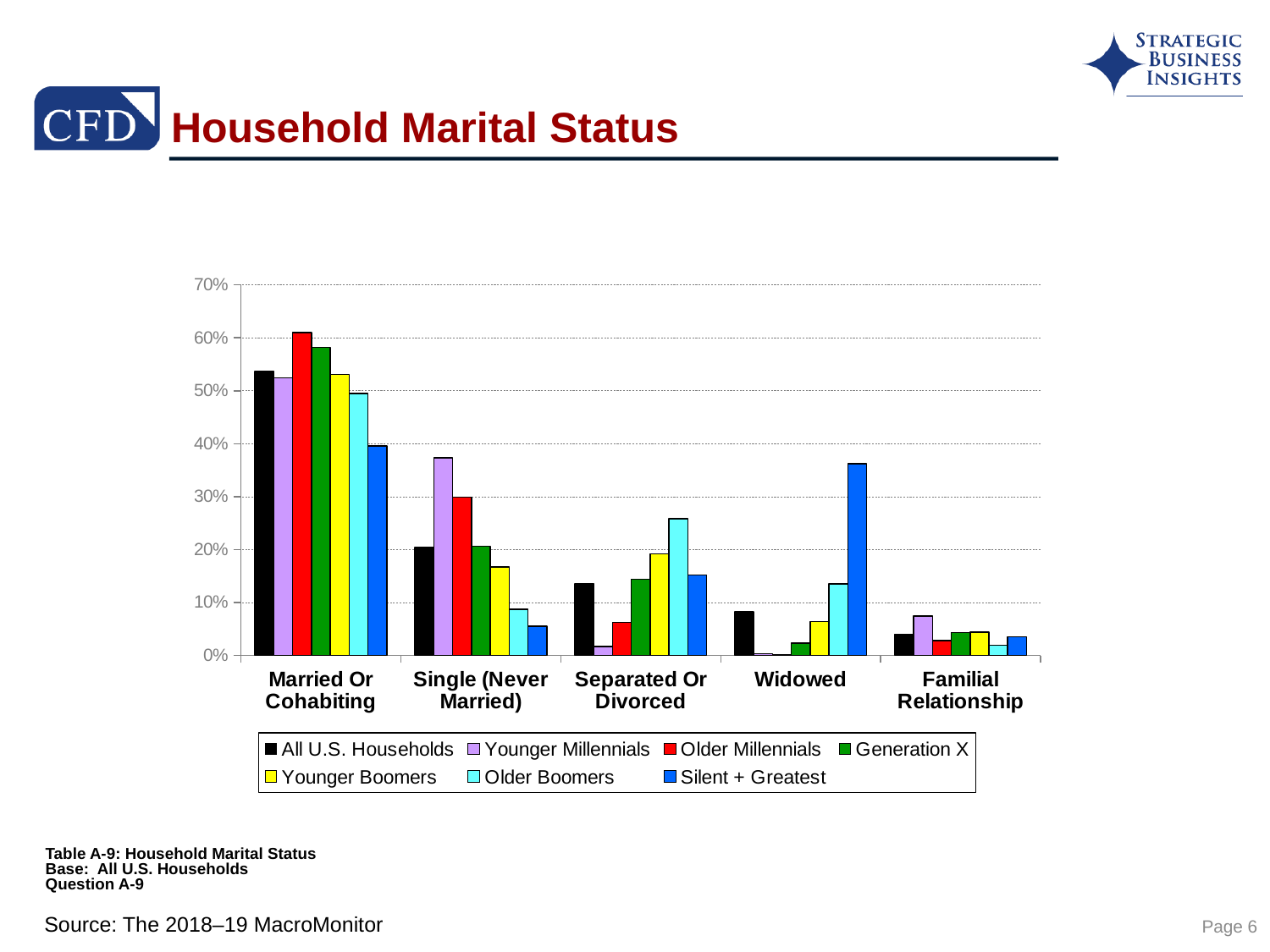
In the Married Or Cohabiting category, which series has the highest value? Older Millennials What kind of chart is shown on the slide? bar chart In the Single (Never Married) category, which series has the highest value? Younger Millennials What is the title of the chart? Household Marital Status In the Married Or Cohabiting category, which series has the lowest value? Silent + Greatest Is the value for Younger Millennials in the Single (Never Married) category greater or less than 30%? greater How many series does the legend list? 7 In the Widowed category, which series has the highest value? Silent + Greatest Is the value for Silent + Greatest in the Married Or Cohabiting category greater or less than 50%? less How many marital status categories are shown on the x axis? 5 In the Widowed category, which is larger: Older Boomers or Younger Boomers? Older Boomers